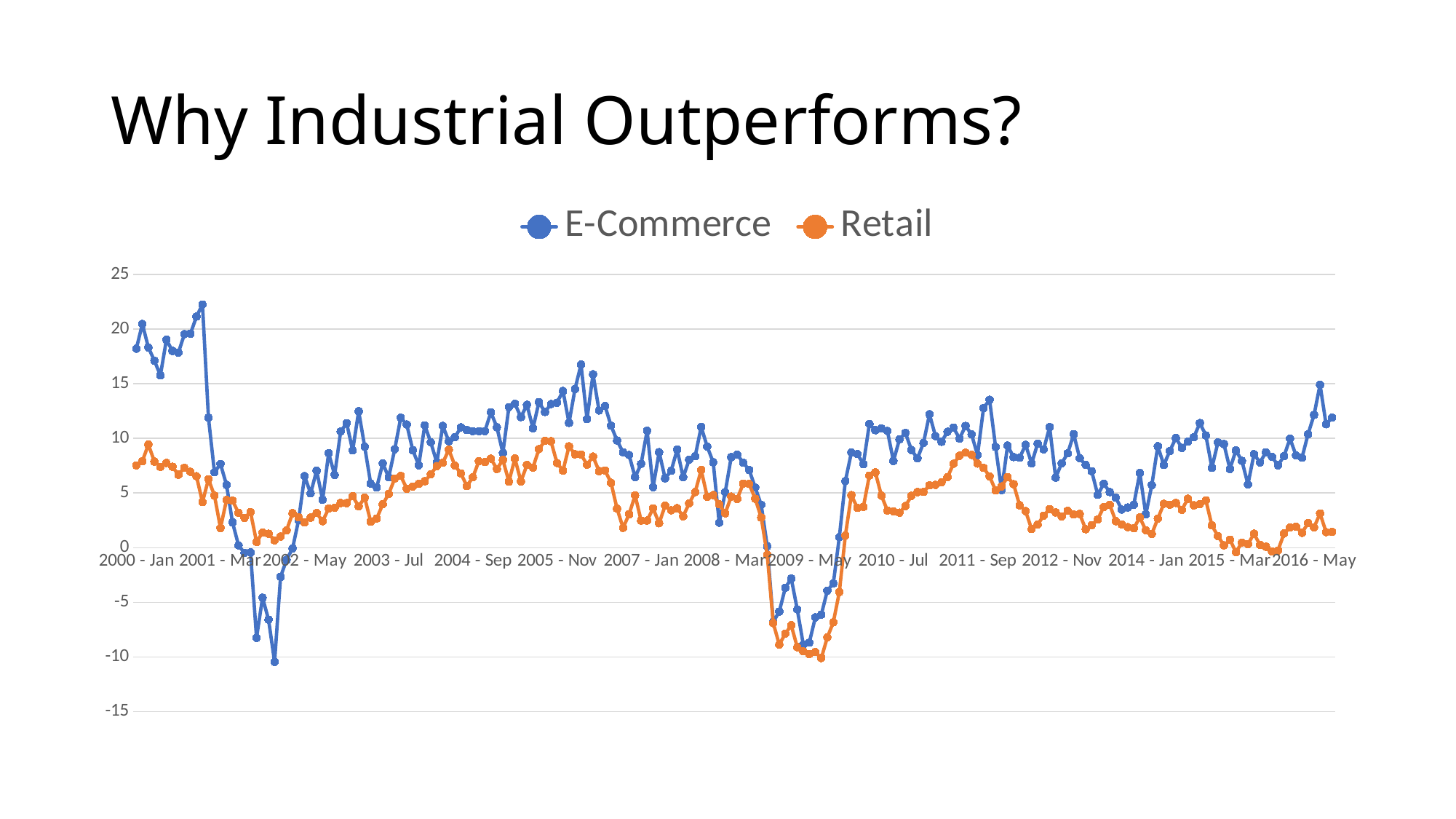
Is the value for E-Commerce at 2016 - May greater or less than 10? greater Do both series rise or fall between 2008 - Mar and 2009 - May? fall Is the value for Retail at 2016 - May greater or less than 5? less How many series does the legend list? 2 Is the highest value of the E-Commerce series greater or less than 20? greater What kind of chart is shown on the slide? line chart What is the title of the slide containing the chart? Why Industrial Outperforms? Which colour represents the Retail series in the chart? orange At 2000 - Jan, which series has the larger value, E-Commerce or Retail? E-Commerce At 2016 - May, which series has the larger value, E-Commerce or Retail? E-Commerce